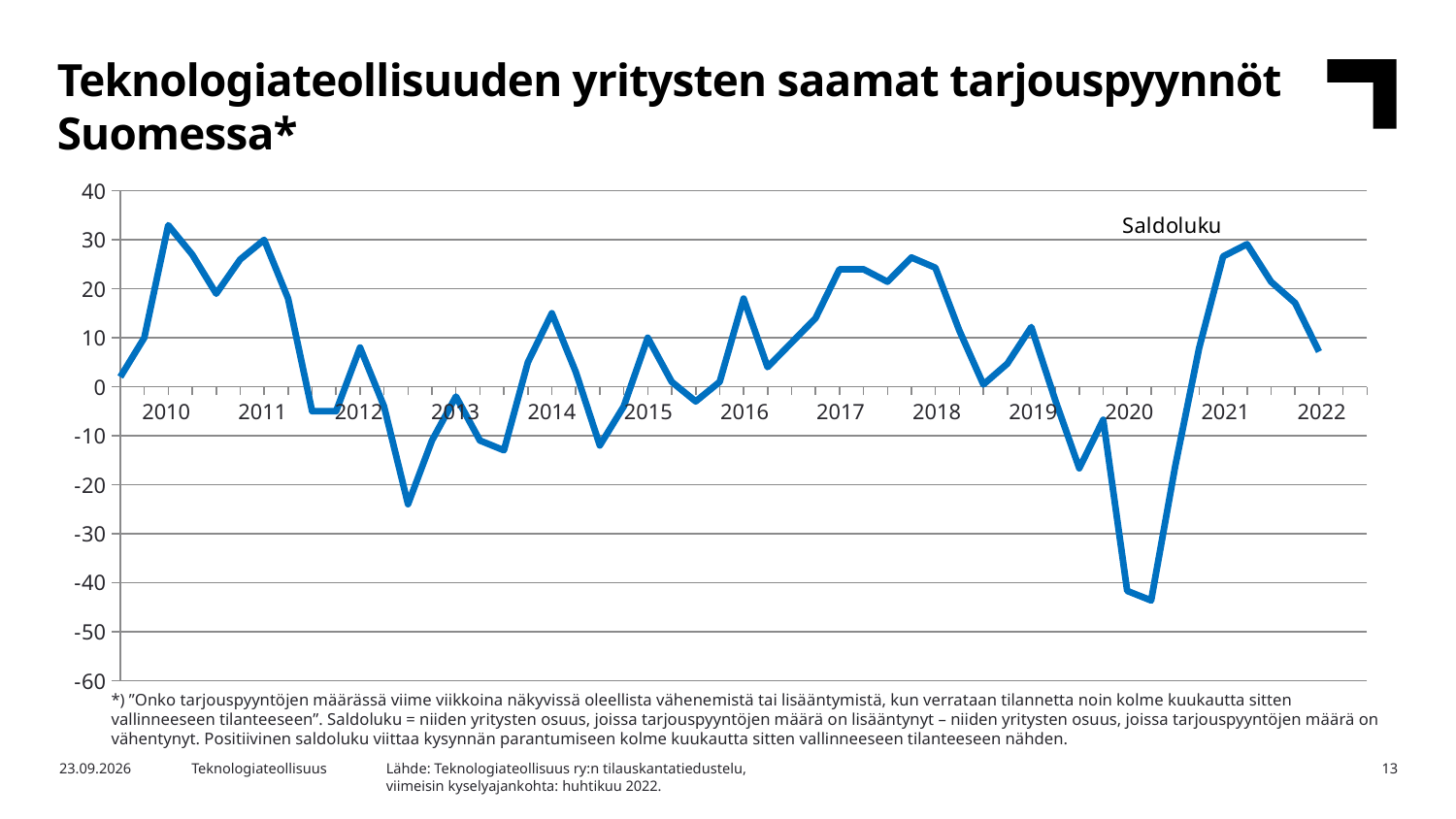
Is the lowest value of the line, reached in 2020, greater or less than -30? less Is the peak value of the line in 2010 greater or less than 20? greater What kind of chart is shown on the slide? line chart What is the title of the chart on the slide? Teknologiateollisuuden yritysten saamat tarjouspyynnöt Suomessa* In which year does the line reach its lowest point? 2020 How many year labels are shown on the x axis? 13 Does the line rise or fall between its 2021 peak and the end of 2022? fall What is the name of the series shown in the chart? Saldoluku Does the line rise or fall between its 2020 low point and 2021? rise Is the lowest value of the line in 2012 greater or less than -20? less